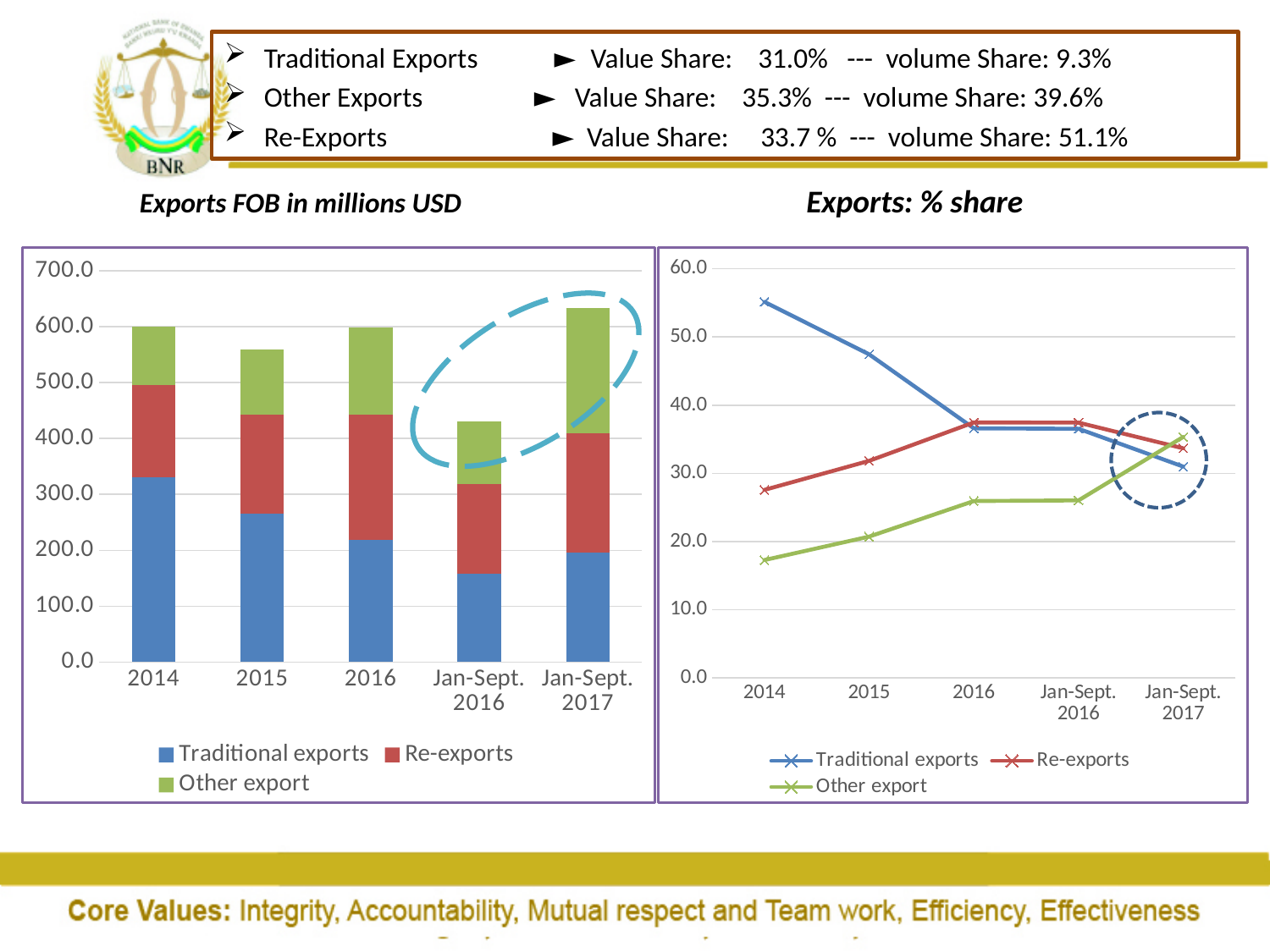
In the 'Exports: % share' chart, is the value for Other export in 2014 greater or less than 20? less In the 'Exports: % share' chart, how many periods are shown on the x axis? 5 What kind of chart is the 'Exports: % share' chart on the right? Line chart In the 'Exports FOB in millions USD' chart, is the value for Traditional exports in 2014 greater or less than 300? greater In the 'Exports: % share' chart, is the value for Traditional exports in 2014 greater or less than 50? greater What kind of chart is the 'Exports FOB in millions USD' chart on the left? Stacked bar chart In the 'Exports: % share' chart, which series has the highest share in 2014? Traditional exports In the 'Exports FOB in millions USD' chart, which period has the lowest total stacked bar? Jan-Sept. 2016 In the 'Exports: % share' chart, does the Traditional exports line rise or fall from 2014 to Jan-Sept. 2017? Fall In the 'Exports FOB in millions USD' chart, how many series does the legend list? 3 In the 'Exports FOB in millions USD' chart, which period has the highest total stacked bar? Jan-Sept. 2017